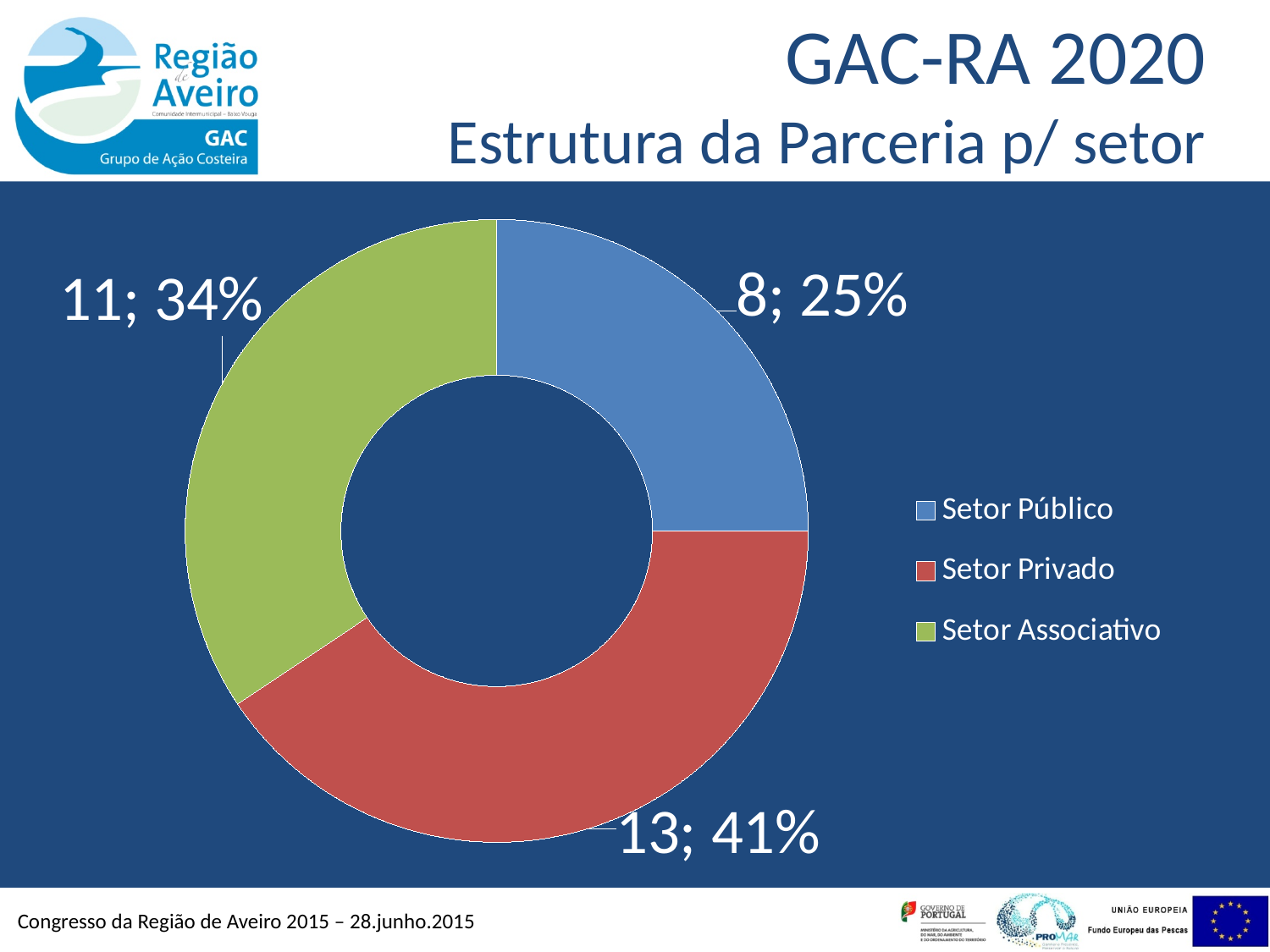
What is the difference between the values for Setor Privado and Setor Público? 5 What share of the chart does Setor Privado represent? 41% What is the value for Setor Privado? 13 Which colour represents Setor Associativo in the chart? Green What is the value for Setor Associativo? 11 Which sector has the smallest value? Setor Público What is the value for Setor Público? 8 What kind of chart is shown on the slide? Doughnut (pie) chart How many sectors does the legend list? 3 Which sector has the largest value? Setor Privado What share of the chart does Setor Associativo represent? 34% What share of the chart does Setor Público represent? 25%